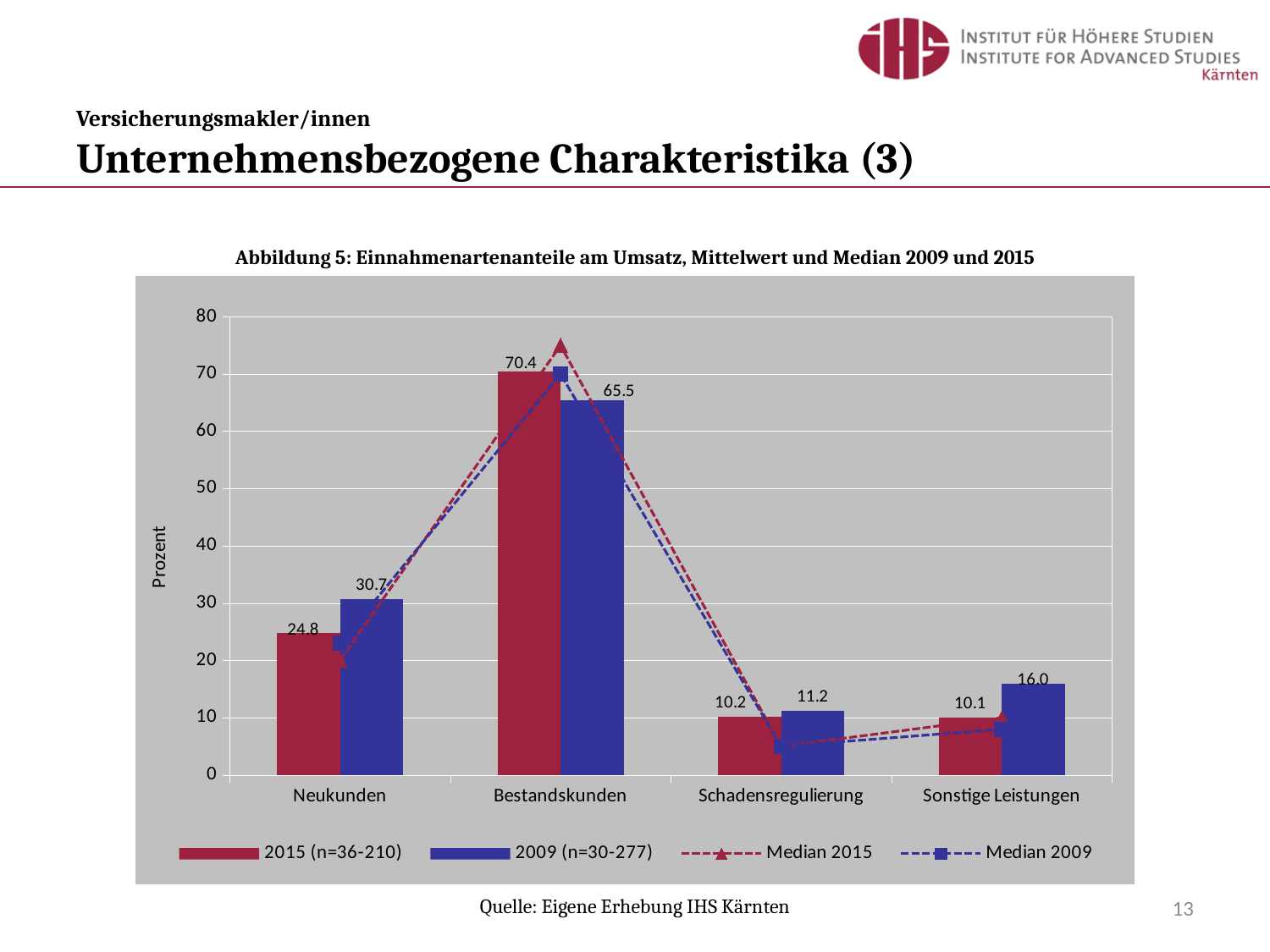
Which category has the lowest 2009 (n=30-277) bar? Schadensregulierung What is the value of the 2015 (n=36-210) bar for Neukunden? 24.8 What is the difference between the 2015 (n=36-210) and 2009 (n=30-277) bars for Bestandskunden? 4.9 How much higher is the 2009 (n=30-277) bar than the 2015 (n=36-210) bar for Neukunden? 5.9 How many categories are shown on the x axis? 4 What is the value of the 2015 (n=36-210) bar for Bestandskunden? 70.4 What is the value of the 2009 (n=30-277) bar for Sonstige Leistungen? 16.0 Is the Median 2015 value for Bestandskunden greater or less than 70? greater Which category has the highest 2009 (n=30-277) bar? Bestandskunden For Schadensregulierung, which bar is larger: 2015 (n=36-210) or 2009 (n=30-277)? 2009 (n=30-277) How many series does the legend list? 4 Is the Median 2009 value for Schadensregulierung greater or less than 10? less